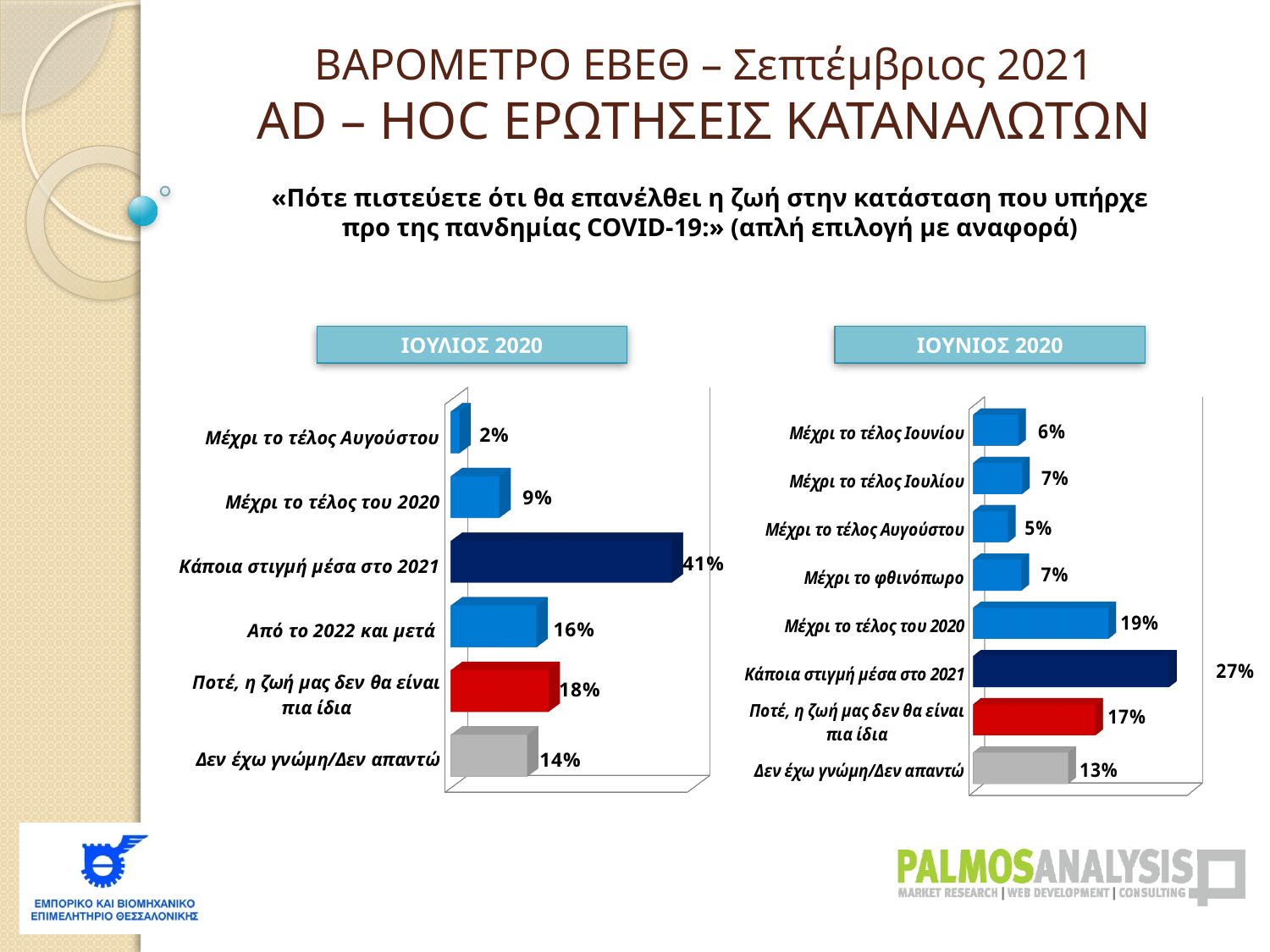
In the ΙΟΥΝΙΟΣ 2020 chart, which is larger: "Ποτέ, η ζωή μας δεν θα είναι πια ίδια" or "Δεν έχω γνώμη/Δεν απαντώ"? Ποτέ, η ζωή μας δεν θα είναι πια ίδια In the ΙΟΥΛΙΟΣ 2020 chart, what is the value for "Κάποια στιγμή μέσα στο 2021"? 41% In the ΙΟΥΝΙΟΣ 2020 chart, which category has the highest value? Κάποια στιγμή μέσα στο 2021 In the ΙΟΥΝΙΟΣ 2020 chart, which category has the lowest value? Μέχρι το τέλος Αυγούστου What type of chart is the ΙΟΥΛΙΟΣ 2020 chart? Bar chart In the ΙΟΥΛΙΟΣ 2020 chart, which category has the lowest value? Μέχρι το τέλος Αυγούστου In the ΙΟΥΛΙΟΣ 2020 chart, what is the value for "Ποτέ, η ζωή μας δεν θα είναι πια ίδια"? 18% In the ΙΟΥΝΙΟΣ 2020 chart, what is the difference between "Κάποια στιγμή μέσα στο 2021" and "Μέχρι το τέλος του 2020"? 8% In the ΙΟΥΝΙΟΣ 2020 chart, what is the value for "Μέχρι το τέλος του 2020"? 19% In the ΙΟΥΛΙΟΣ 2020 chart, what is the difference between "Από το 2022 και μετά" and "Μέχρι το τέλος του 2020"? 7% In the ΙΟΥΛΙΟΣ 2020 chart, how many categories are shown? 6 In the ΙΟΥΝΙΟΣ 2020 chart, how many categories are shown? 8